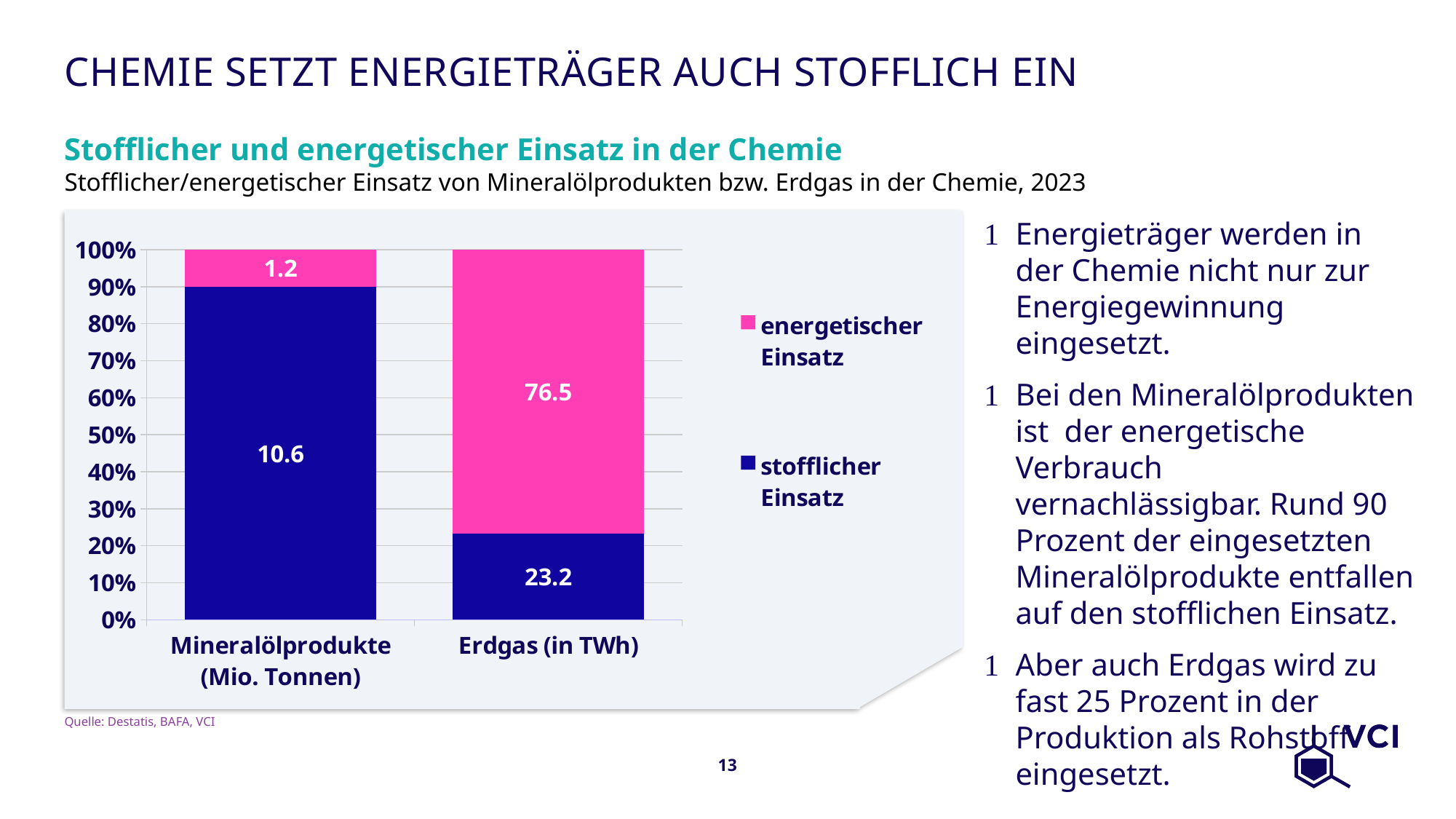
What is the data label for energetischer Einsatz in the Mineralölprodukte (Mio. Tonnen) bar? 1.2 Is the share of stofflicher Einsatz in the Mineralölprodukte (Mio. Tonnen) bar greater or less than 80%? greater What is the data label for energetischer Einsatz in the Erdgas (in TWh) bar? 76.5 What is the sum of the two data labels in the Erdgas (in TWh) bar? 99.7 What is the data label for stofflicher Einsatz in the Mineralölprodukte (Mio. Tonnen) bar? 10.6 How many series does the legend list? 2 In the Erdgas (in TWh) bar, what is the difference between the energetischer Einsatz and stofflicher Einsatz values? 53.3 Is the share of stofflicher Einsatz in the Erdgas (in TWh) bar greater or less than 30%? less What is the data label for stofflicher Einsatz in the Erdgas (in TWh) bar? 23.2 In the Mineralölprodukte (Mio. Tonnen) bar, what is the difference between the stofflicher Einsatz and energetischer Einsatz values? 9.4 In the Erdgas (in TWh) bar, which series has the larger value, energetischer Einsatz or stofflicher Einsatz? energetischer Einsatz What kind of chart is shown on the slide? Stacked bar chart